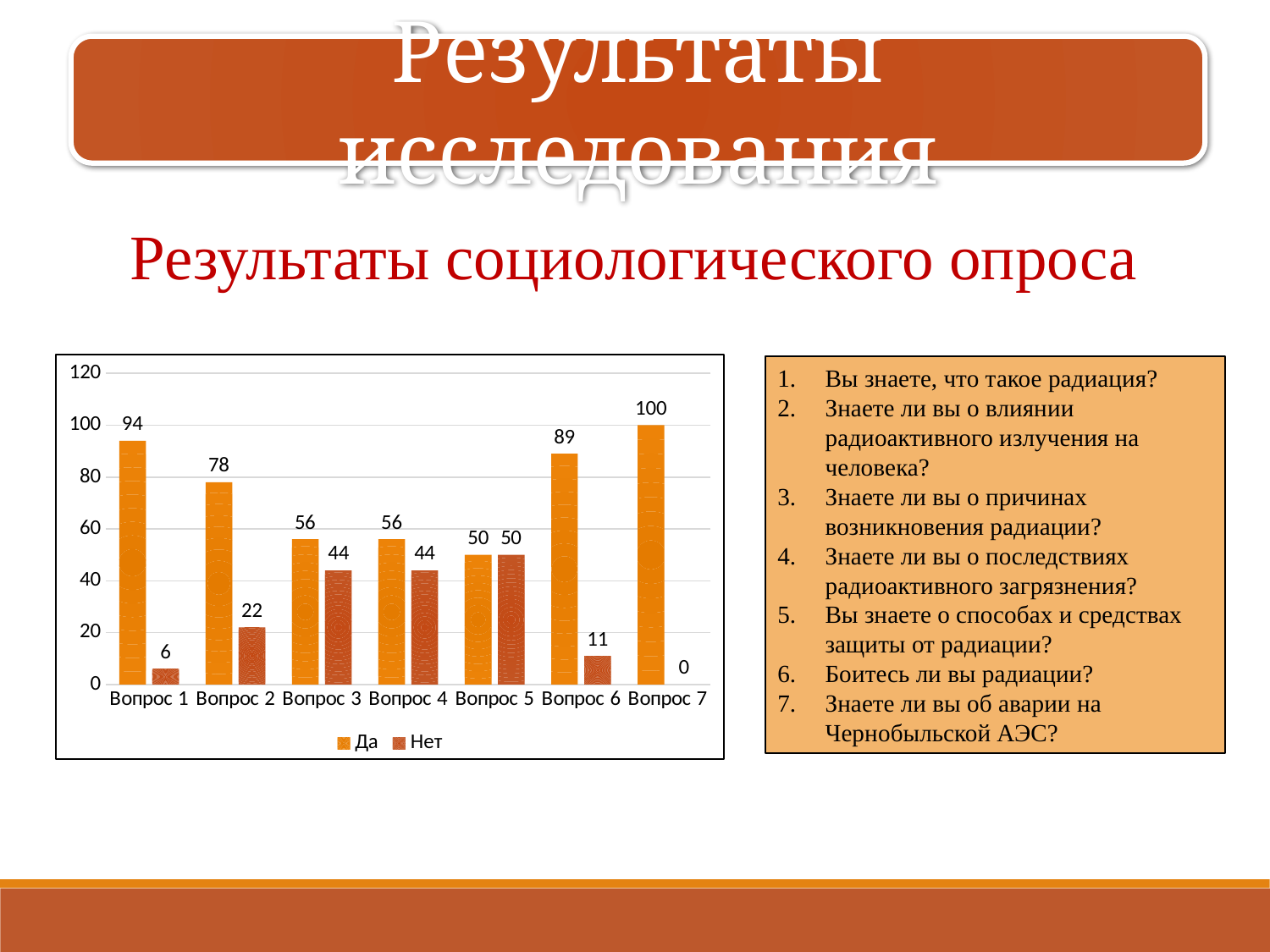
How many series does the legend list? 2 What is the value of "Нет" for Вопрос 2? 22 Which category has the lowest "Нет" value? Вопрос 7 What is the difference between the "Да" and "Нет" values for Вопрос 3? 12 What kind of chart is shown on the slide? Bar chart What is the value of "Нет" for Вопрос 7? 0 What are the two series named in the legend? Да and Нет What is the value of "Да" for Вопрос 1? 94 Which is larger for Вопрос 6: the "Да" value or the "Нет" value? Да What is the total of the "Да" and "Нет" values for Вопрос 5? 100 Which category has the highest "Да" value? Вопрос 7 How many categories (questions) are shown on the x axis? 7